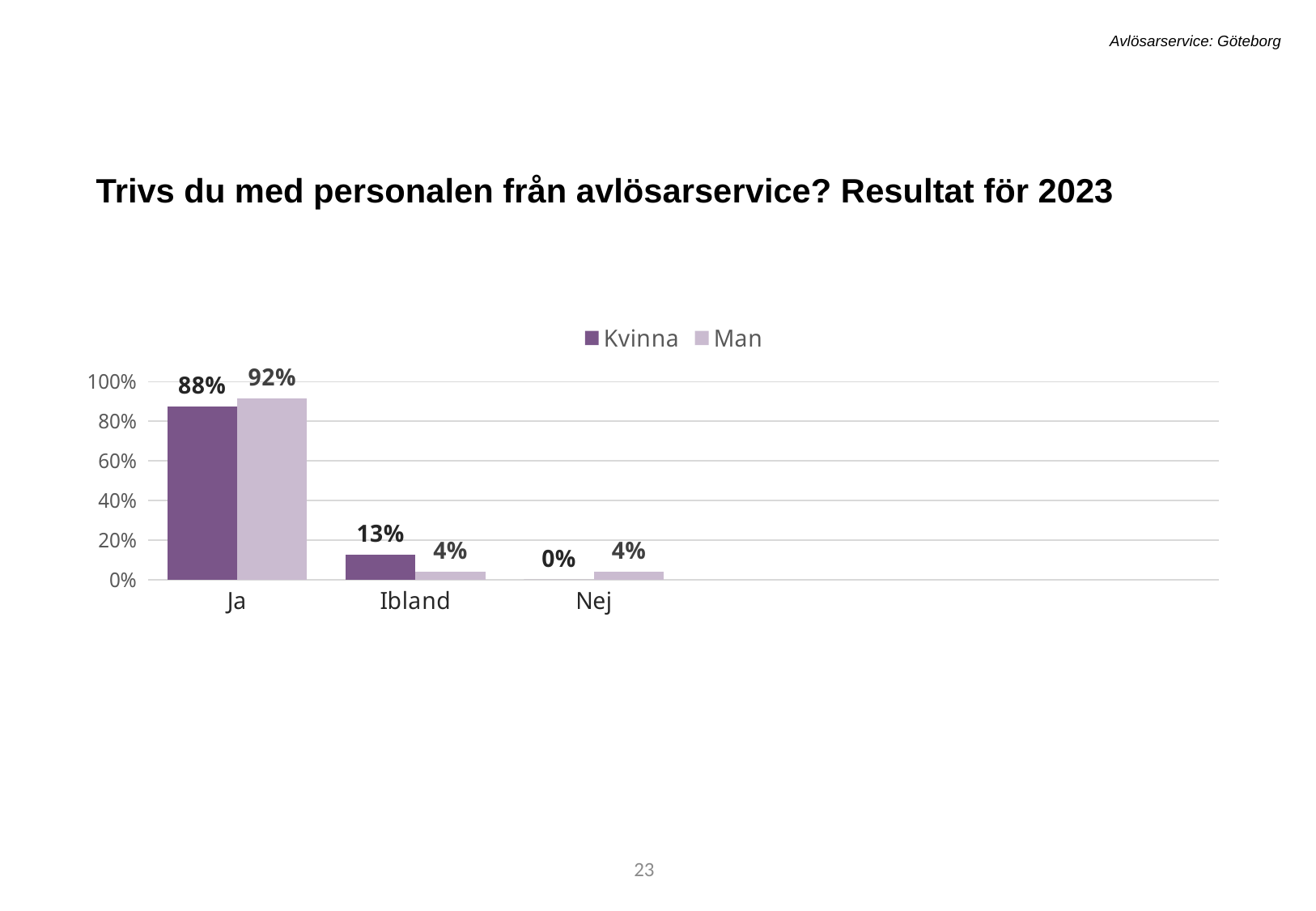
What is the value for Kvinna in the Ibland category? 13% How many series does the legend list? 2 What is the value for Kvinna in the Nej category? 0% In the Ibland category, which series has the larger value, Kvinna or Man? Kvinna What is the value for Kvinna in the Ja category? 88% What kind of chart is shown on the slide? Bar chart Which category has the lowest value for the Kvinna series? Nej How many categories are shown on the x axis? 3 Which category has the highest value for the Man series? Ja What is the value for Man in the Nej category? 4% What is the difference between the Man and Kvinna values in the Ja category? 4% What is the value for Man in the Ja category? 92%